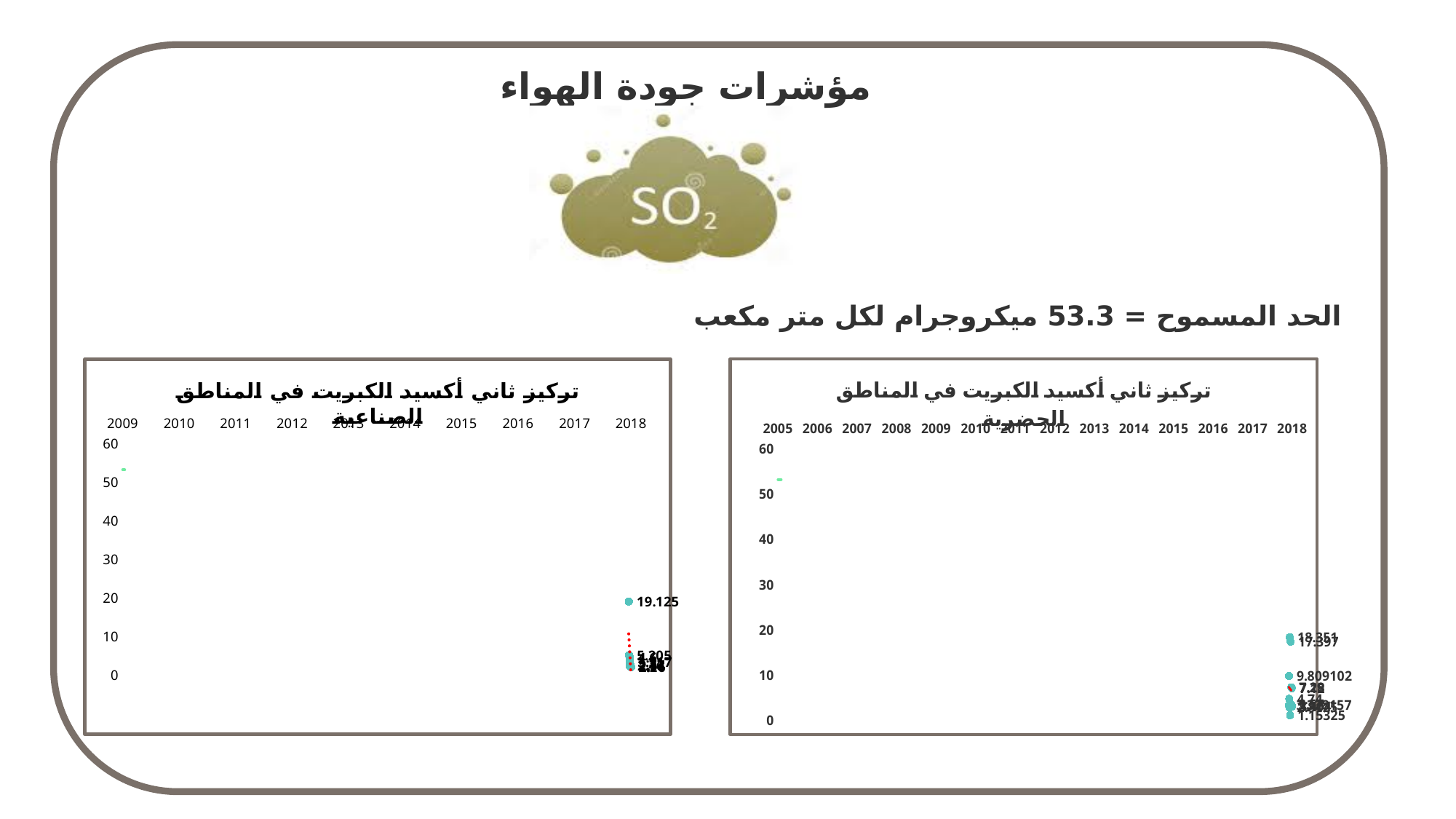
In the left chart (industrial areas), what is the first year shown on the x axis? 2009 In the right chart (urban areas), what is the maximum value shown on the y axis? 60 In the left chart (industrial areas), what is the highest labelled data value? 19.125 What kind of chart is the chart on the right (urban areas)? line chart In the left chart (industrial areas), how many years are shown on the x axis? 10 In the right chart (urban areas), which is larger: the value labelled 7.28 or the value labelled 4.74? 7.28 In the right chart (urban areas), is the value labelled 9.809102 greater or less than 10? less In the right chart (urban areas), what is the lowest labelled data value? 1.15325 In the left chart (industrial areas), is the highest labelled value greater or less than 20? less In the right chart (urban areas), how many years are shown on the x axis? 14 What is the title of the chart on the right? تركيز ثاني أكسيد الكبريت في المناطق الحضرية What is the title of the chart on the left? تركيز ثاني أكسيد الكبريت في المناطق الصناعية